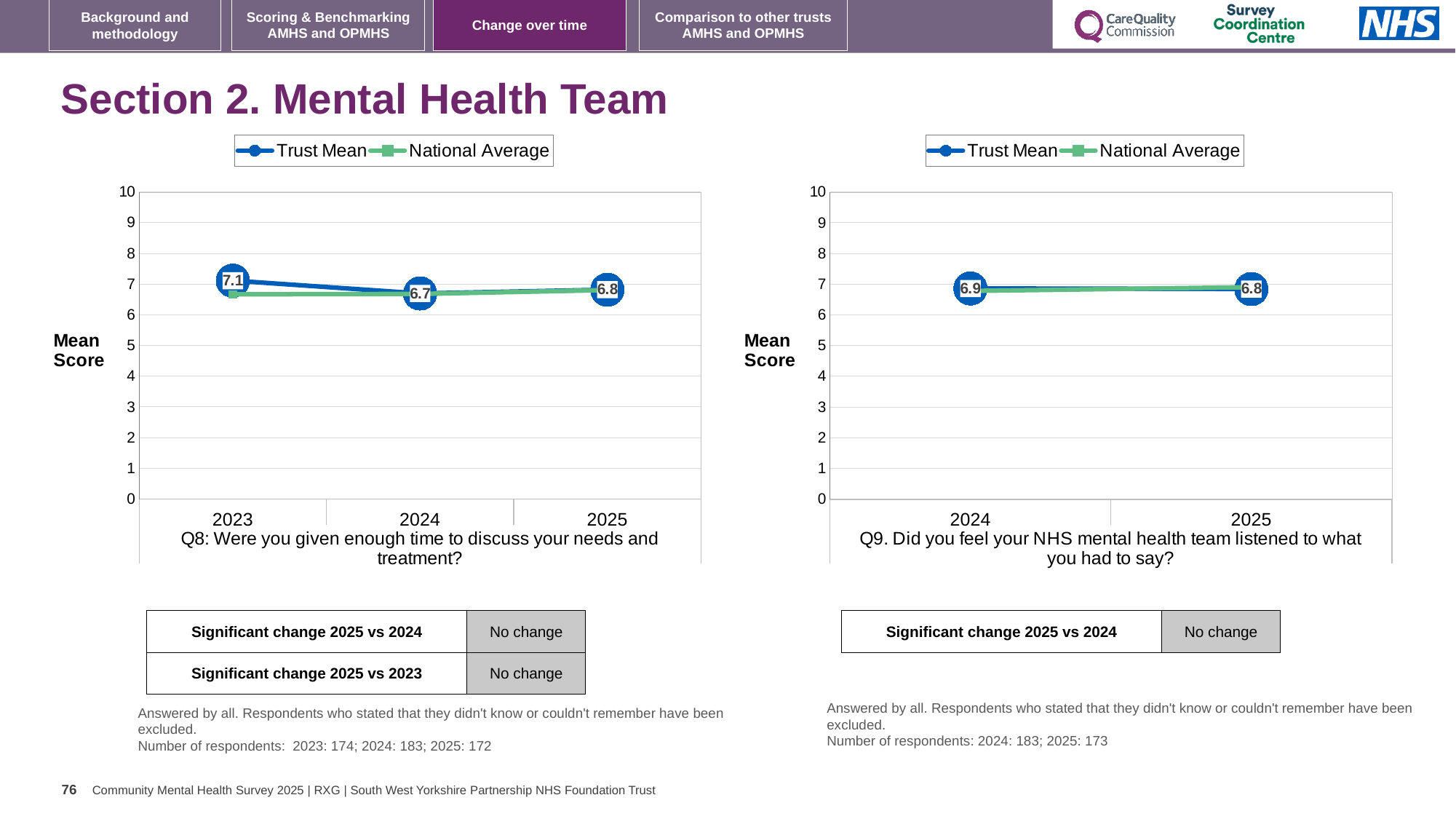
In the Q8 chart (left), what is the Trust Mean for 2023? 7.1 What kind of chart is the Q8 chart (left)? Line chart How many series does the legend of the Q9 chart (right) list? 2 How many years are plotted on the x axis of the Q8 chart (left)? 3 In the Q9 chart (right), what is the difference between the Trust Mean for 2024 and 2025? 0.1 In the Q9 chart (right), what is the Trust Mean for 2024? 6.9 In the Q8 chart (left), what is the Trust Mean for 2024? 6.7 In the Q9 chart (right), what is the Trust Mean for 2025? 6.8 In the Q8 chart (left), what is the difference between the Trust Mean for 2023 and 2024? 0.4 In the Q8 chart (left), which year has the lowest Trust Mean? 2024 In the Q8 chart (left), what is the Trust Mean for 2025? 6.8 In the Q8 chart (left), which year has the highest Trust Mean? 2023